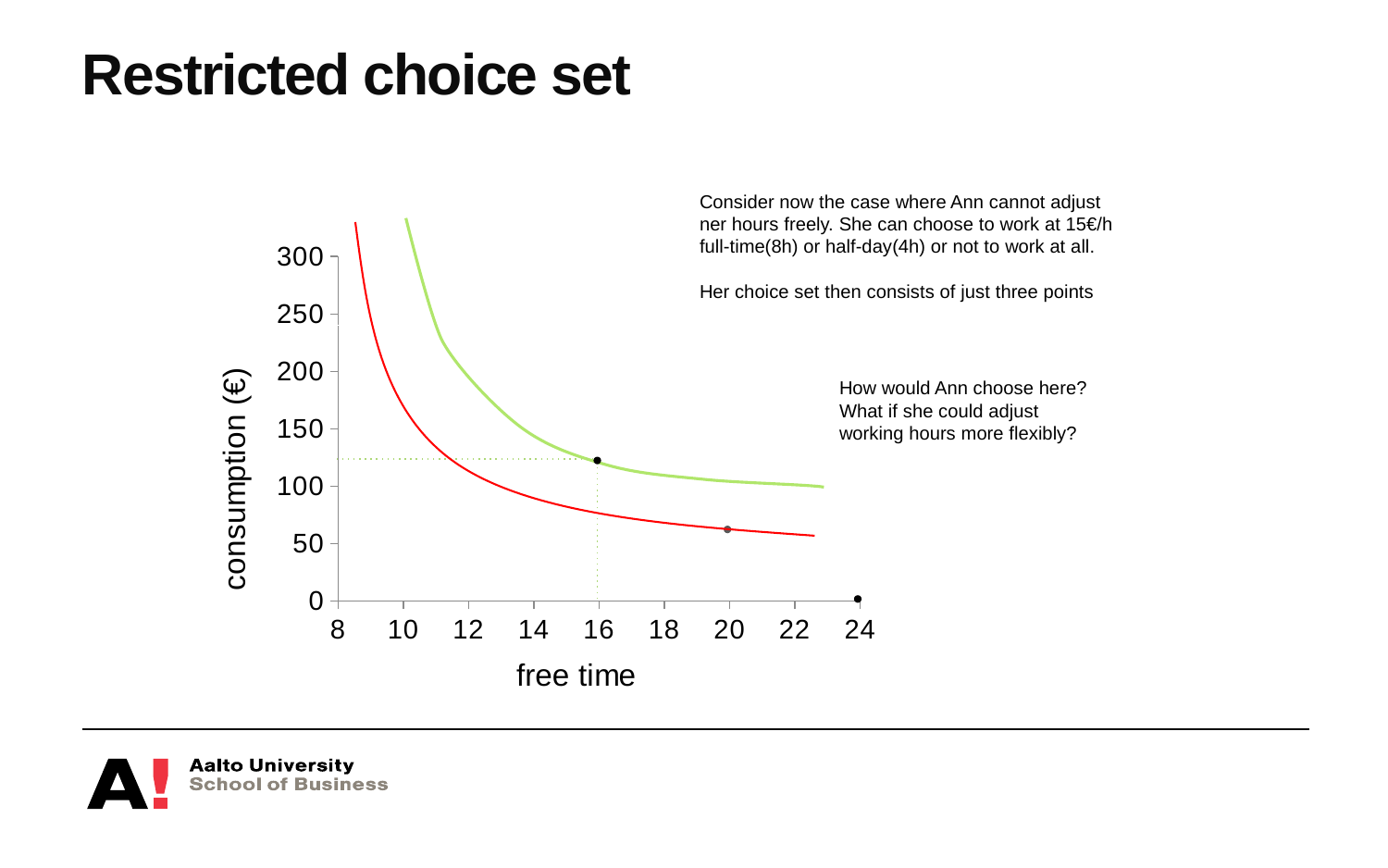
Is the consumption value of the plotted point at free time 20 greater or less than 100? less What is the consumption value of the plotted point at free time 24? 0 What kind of chart is shown on the slide? line chart At which free time value does the plotted point with the lowest consumption lie? 24 Do the curves rise or fall as free time increases along the x axis? fall Is the consumption value of the plotted point at free time 16 greater or less than 100? greater Which plotted point has the highest consumption: the one at free time 16 or the one at free time 20? free time 16 Is the consumption value of the plotted point at free time 20 greater or less than 50? greater At which free time value does the plotted point with the highest consumption lie? 16 How many points are plotted on the chart? 3 What is the label of the x axis? free time